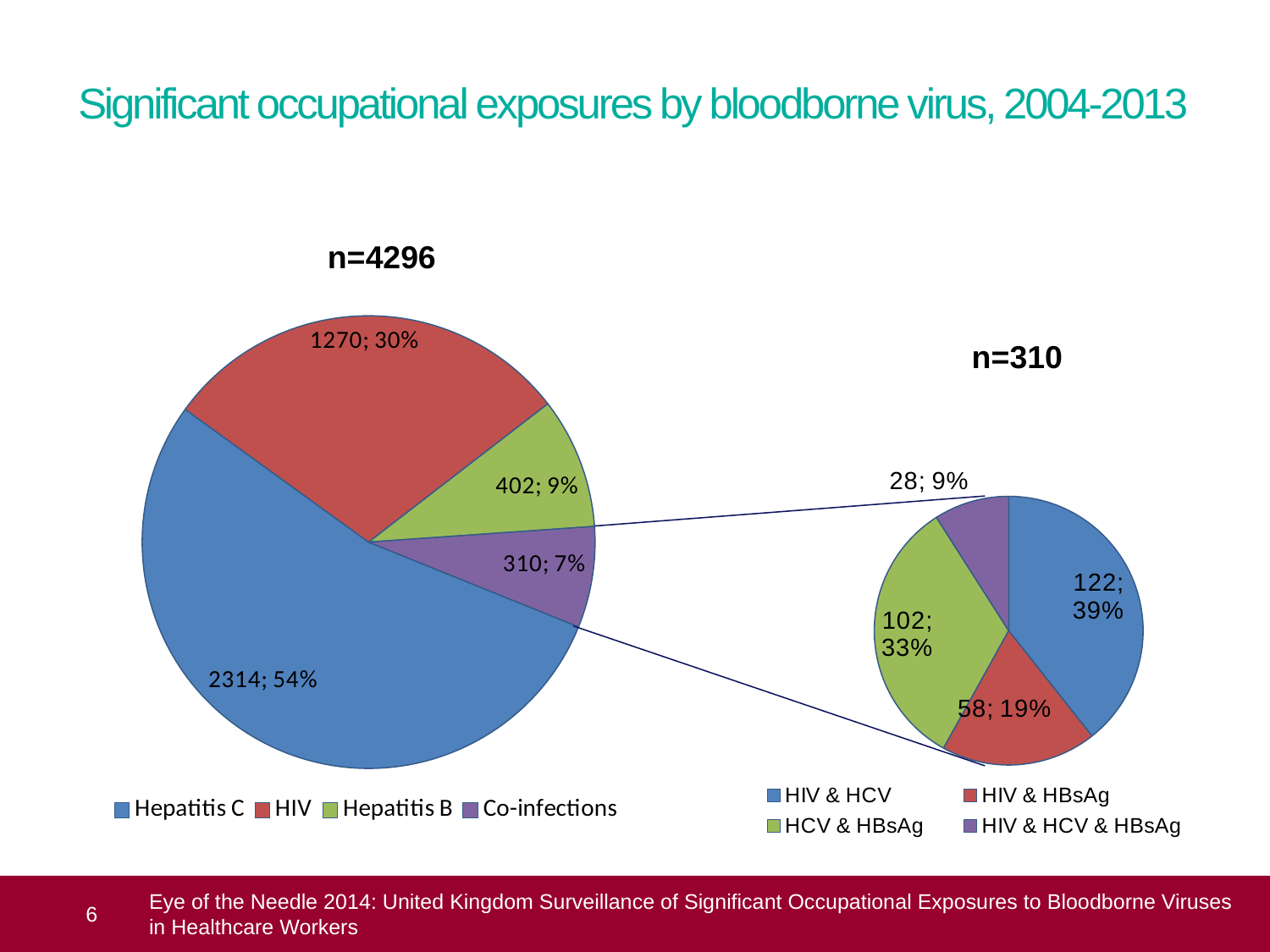
In the n=310 pie chart on the right, what percentage share does HCV & HBsAg have? 33% In the n=4296 pie chart on the left, how many categories does the legend list? 4 In the n=4296 pie chart on the left, how many exposures are attributed to Hepatitis C? 2314 In the n=310 pie chart on the right, which category has the largest slice? HIV & HCV In the n=4296 pie chart on the left, what is the difference between the Hepatitis C count and the HIV count? 1044 What type of chart is used on this slide? Pie chart In the n=4296 pie chart on the left, which category has the smallest slice? Co-infections In the n=310 pie chart on the right, how many exposures are HIV & HCV co-infections? 122 In the n=4296 pie chart on the left, which is larger, Hepatitis B or Co-infections? Hepatitis B In the n=310 pie chart on the right, what is the difference between the HCV & HBsAg count and the HIV & HBsAg count? 44 In the n=310 pie chart on the right, which category is shown in purple? HIV & HCV & HBsAg In the n=4296 pie chart on the left, what percentage share does HIV have? 30%